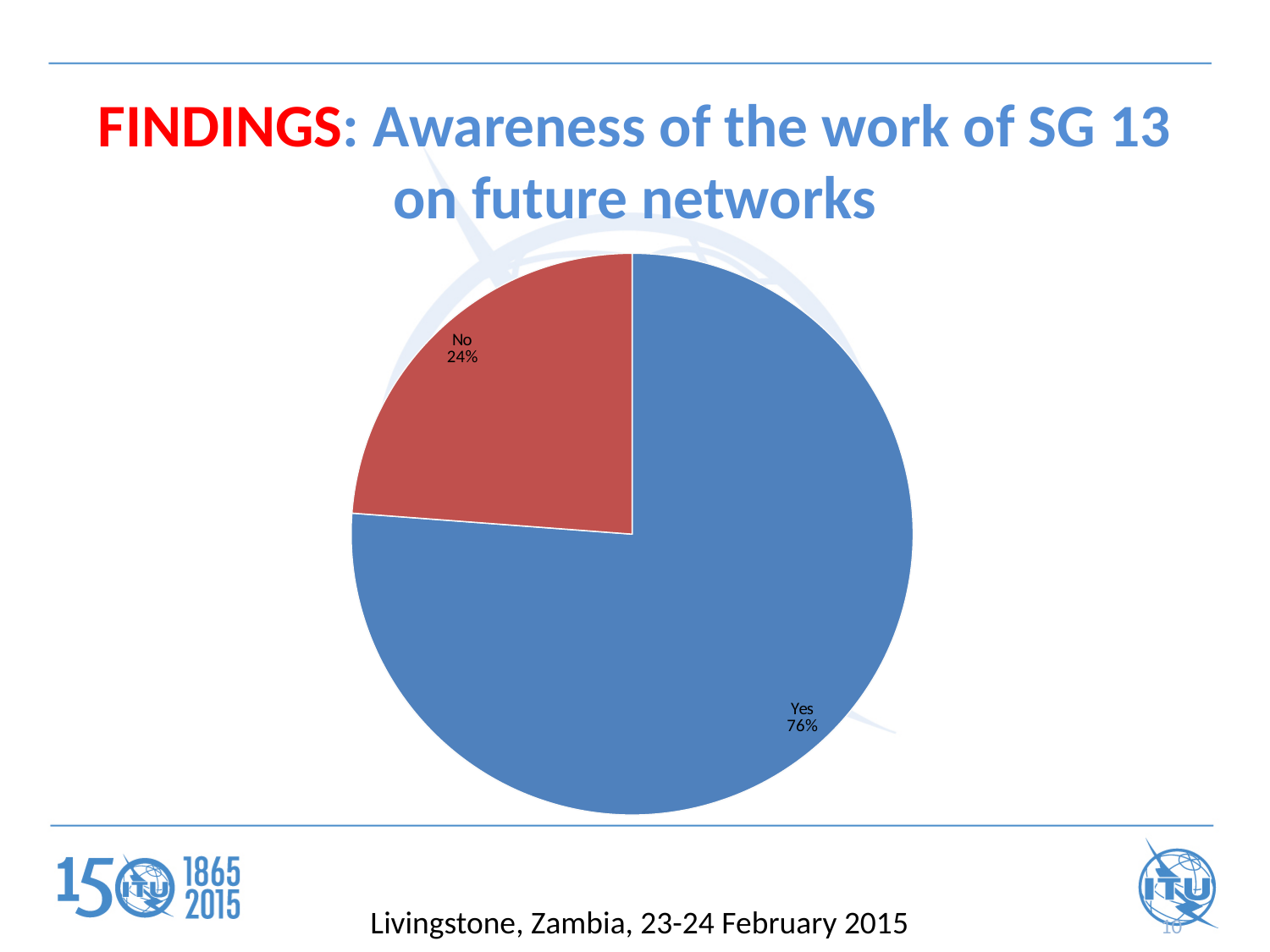
Which is larger, the "Yes" slice or the "No" slice? Yes What share of the pie does the "Yes" slice represent? 76% Which slice is the smallest in the pie chart? No How many slices does the pie chart have? 2 What share of the pie does the "No" slice represent? 24% What kind of chart is shown on the slide? pie chart What is the difference in percentage points between the "Yes" and "No" slices? 52 What colour is the "Yes" slice in the pie chart? blue Which slice is the largest in the pie chart? Yes What colour is the "No" slice in the pie chart? red